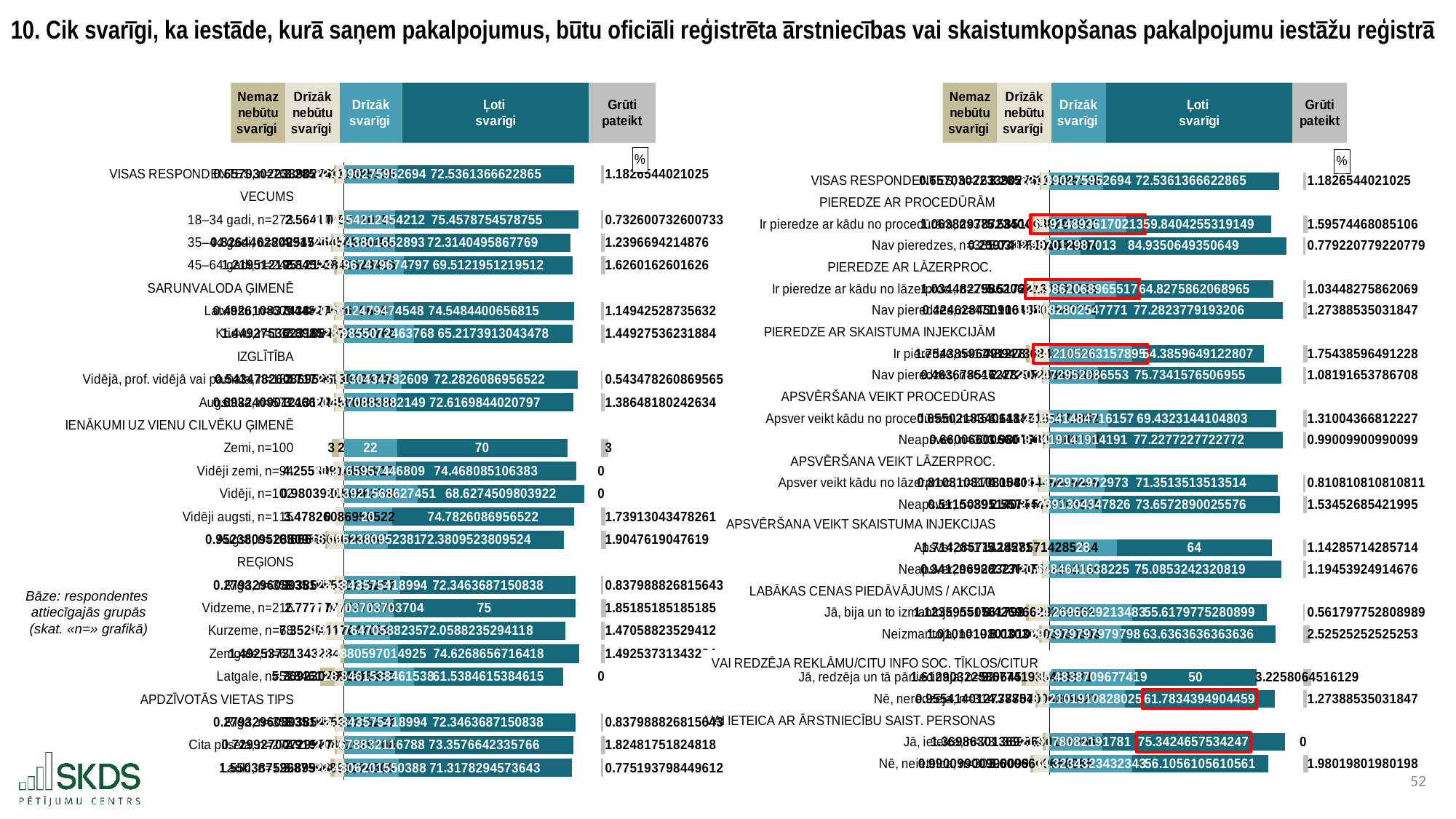
In the right chart, what is the 'Grūti pateikt' value for 'Jā, ieteica'? 0 In the left chart, which has the larger 'Ļoti svarīgi' value: 'Zemi, n=100' or 'Vidzeme, n=216'? Vidzeme, n=216 In the right chart, what is the 'Ļoti svarīgi' value for 'Jā, redzēja un tā pārliecināja'? 50 What kind of chart is the left chart? bar chart In the left chart, what is the 'Ļoti svarīgi' value for 'Zemi, n=100'? 70 In the left chart, what is the 'Grūti pateikt' value for 'Vidzeme, n=216'? 1.85185185185185 In the left chart, what is the 'Drīzāk svarīgi' value for 'Zemi, n=100'? 22 In the left chart, what is the 'Ļoti svarīgi' value for 'Vidzeme, n=216'? 75 In the left chart, what is the total of the stacked bar for 'Zemi, n=100'? 100 In the left chart, what is the difference between the 'Ļoti svarīgi' values for 'Vidzeme, n=216' and 'Zemi, n=100'? 5 In the right chart, what is the 'Ļoti svarīgi' value for 'Nē, neredzēja'? 61.7834394904459 How many series does the legend of the left chart list? 5